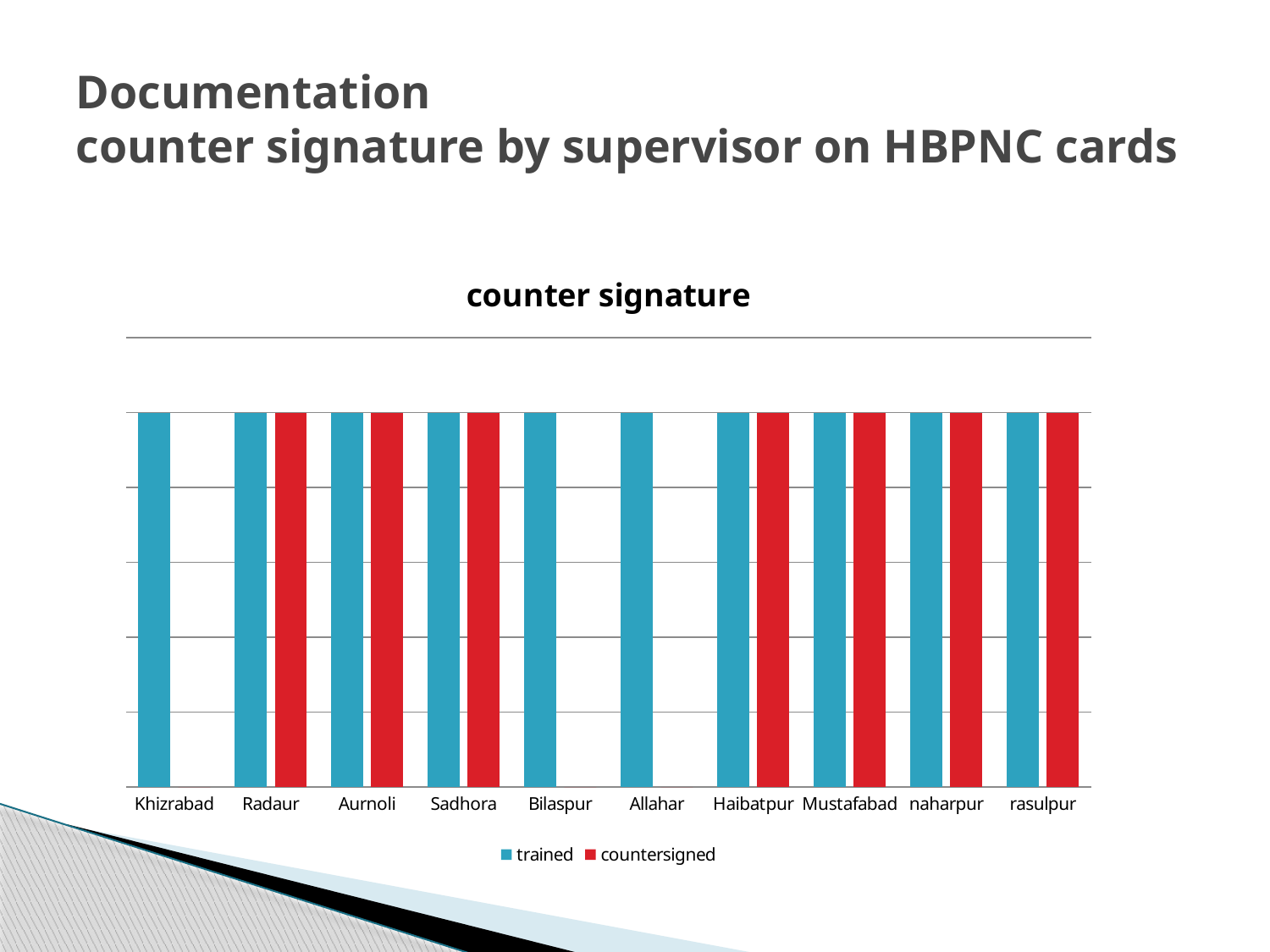
What kind of chart is shown on the slide? bar chart What is the last category on the x axis of the chart? rasulpur For Bilaspur, which is larger: trained or countersigned? trained How many categories have a countersigned bar in the chart? 7 Which series is shown in red in the chart? countersigned How many series does the legend of the chart list? 2 What is the title of the chart? counter signature What is the first category on the x axis of the chart? Khizrabad For Khizrabad, which is larger: trained or countersigned? trained For Allahar, which is larger: trained or countersigned? trained